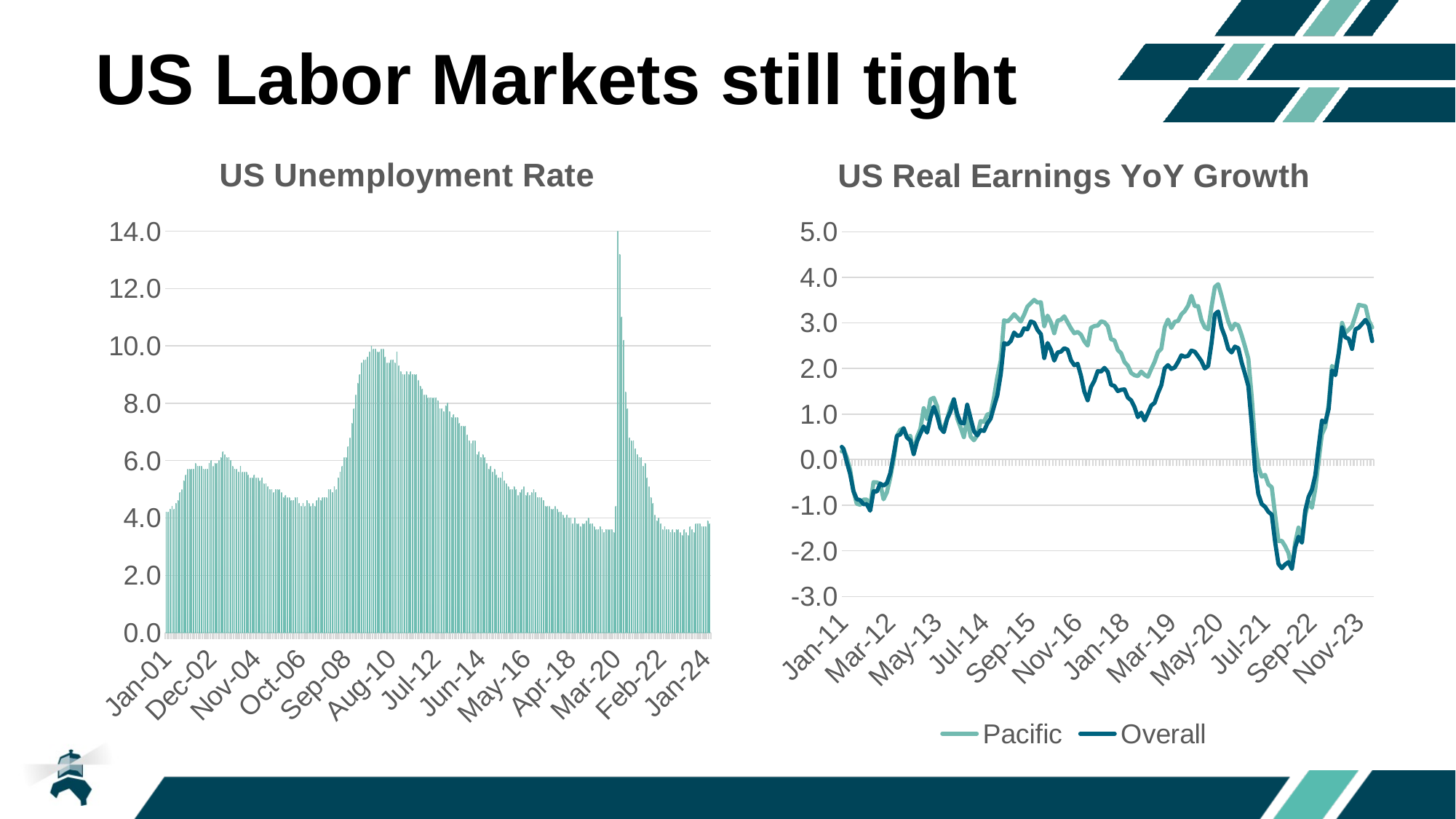
What kind of chart is the US Real Earnings YoY Growth chart on the right? line chart What are the two series named in the legend of the US Real Earnings YoY Growth chart? Pacific and Overall In the US Unemployment Rate chart, is the value at Jan-01 greater or less than 6.0? less In the US Unemployment Rate chart, is the peak value near Mar-20 greater or less than 12.0? greater In the US Real Earnings YoY Growth chart, is the Overall value at its lowest point near Sep-22 greater or less than -1.0? less In the US Real Earnings YoY Growth chart, do the values generally rise or fall between Jan-11 and Sep-15? rise In the US Unemployment Rate chart, do the values rise or fall between Aug-10 and the start of 2020? fall What kind of chart is the US Unemployment Rate chart on the left? bar chart What is the title of the chart on the left side of the slide? US Unemployment Rate How many series does the legend of the US Real Earnings YoY Growth chart list? 2 In the US Real Earnings YoY Growth chart, which series is higher at Jan-18, Pacific or Overall? Pacific